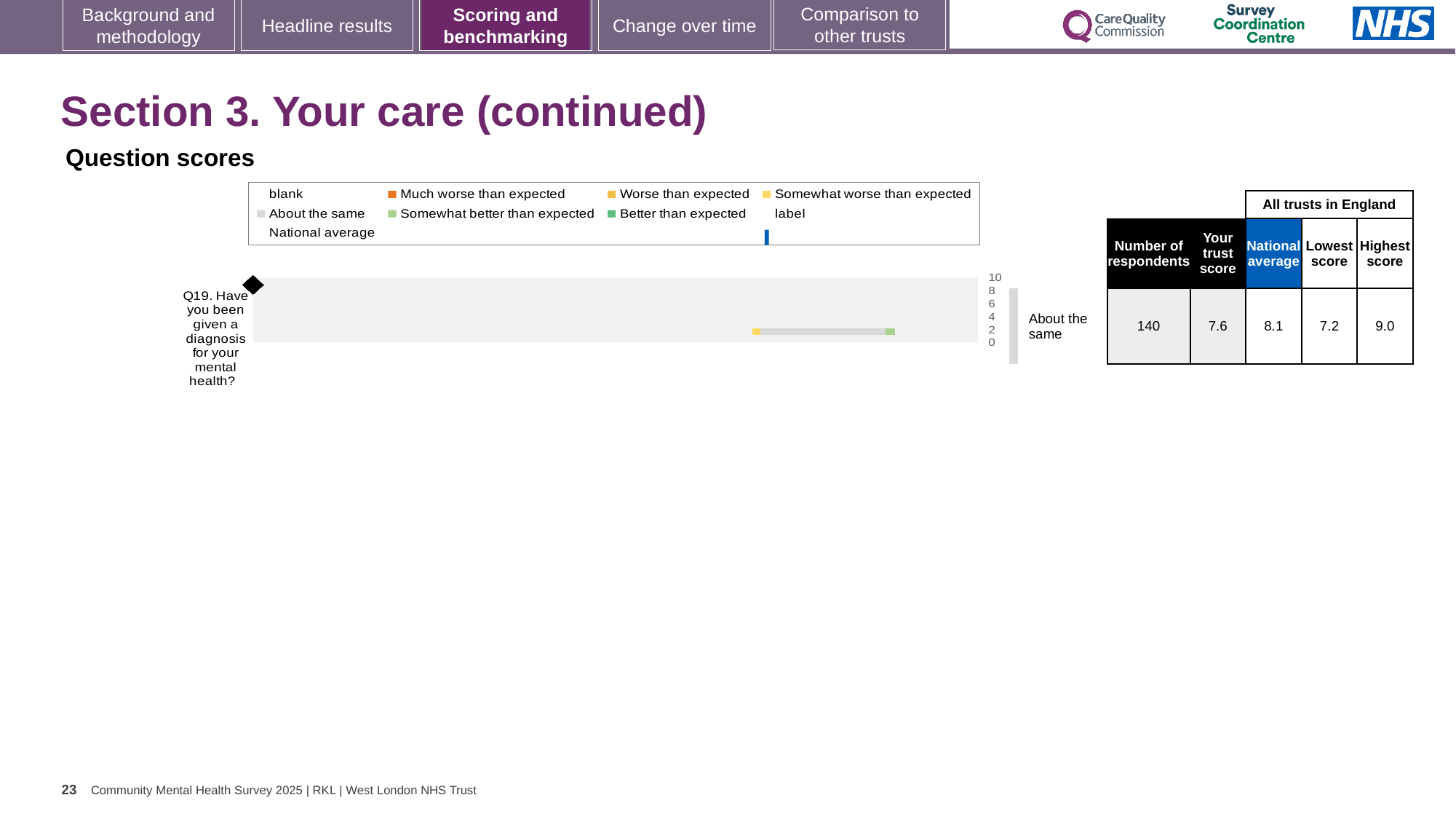
Which question is plotted on the chart? Q19. Have you been given a diagnosis for your mental health? What kind of chart is used to show the question score for Q19? bar chart How many questions are plotted on the chart? 1 What is the trust's score for Q19? 7.6 What is the difference between the highest and lowest scores among all trusts in England for Q19? 1.8 What is the highest score among all trusts in England for Q19? 9.0 Which is larger for Q19, the trust's score or the national average? national average What is the difference between the national average and the trust's score for Q19? 0.5 What is the number of respondents for Q19? 140 What is the lowest score among all trusts in England for Q19? 7.2 What is the national average score for Q19? 8.1 What is the benchmark category shown for Q19? About the same